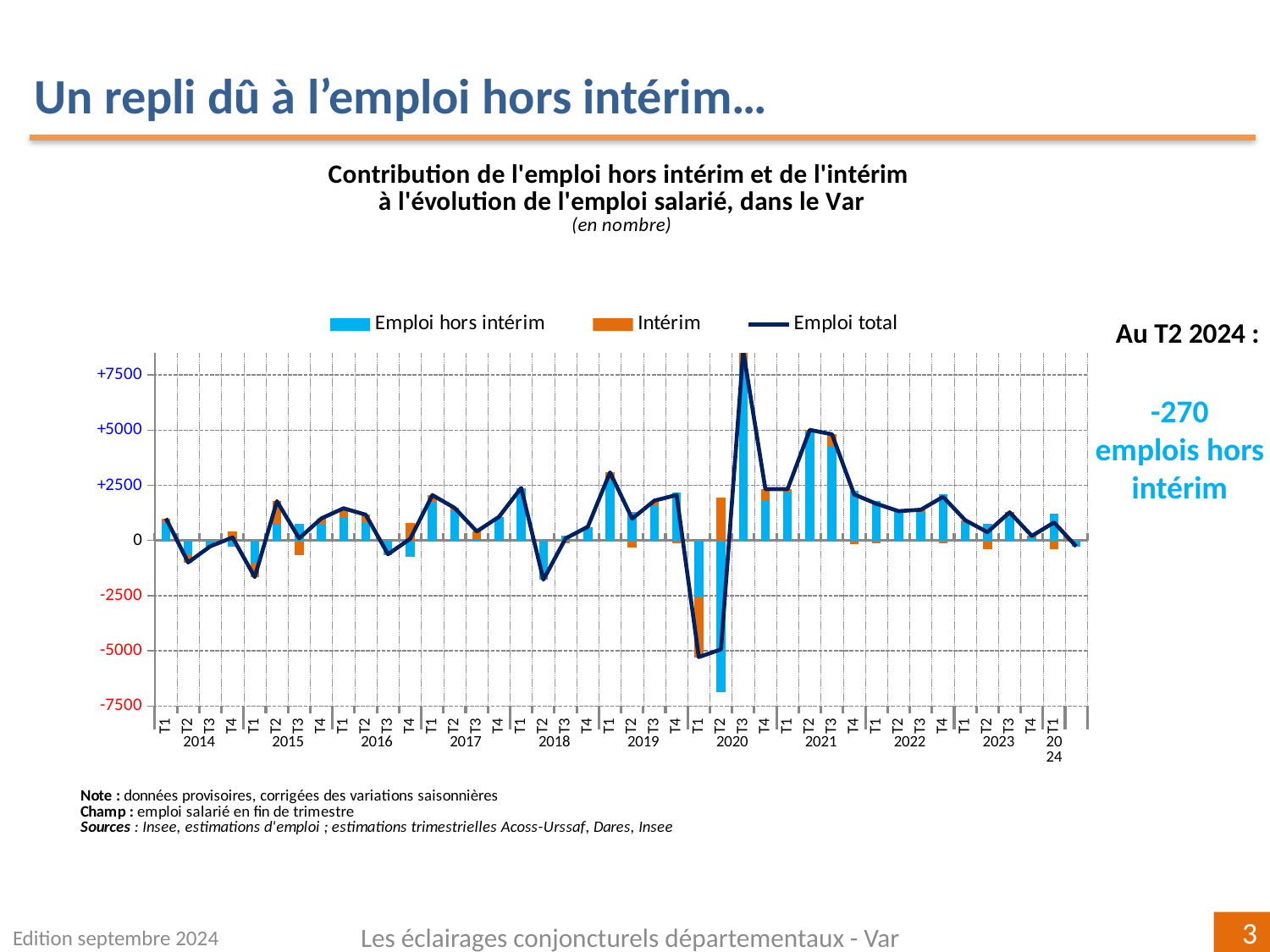
Does Emploi total rise or fall from T2 2021 to T4 2021? Fall In which quarter does Emploi total reach its highest value? T3 2020 Is the value of Emploi total at T3 2020 greater or less than +7500? greater According to the callout, what is the value for Emploi hors intérim at T2 2024? -270 Is the value of Emploi hors intérim at T2 2021 greater or less than +2500? greater Which series is drawn as a line rather than bars? Emploi total Is the value of Emploi hors intérim at T2 2020 greater or less than -5000? less How many series does the legend list? 3 What kind of chart is shown on the slide? A combined bar and line chart In which quarter is the Emploi hors intérim bar at its lowest? T2 2020 What colour are the Intérim bars? Orange Which is larger, Emploi total at T1 2019 or at T2 2019? T1 2019